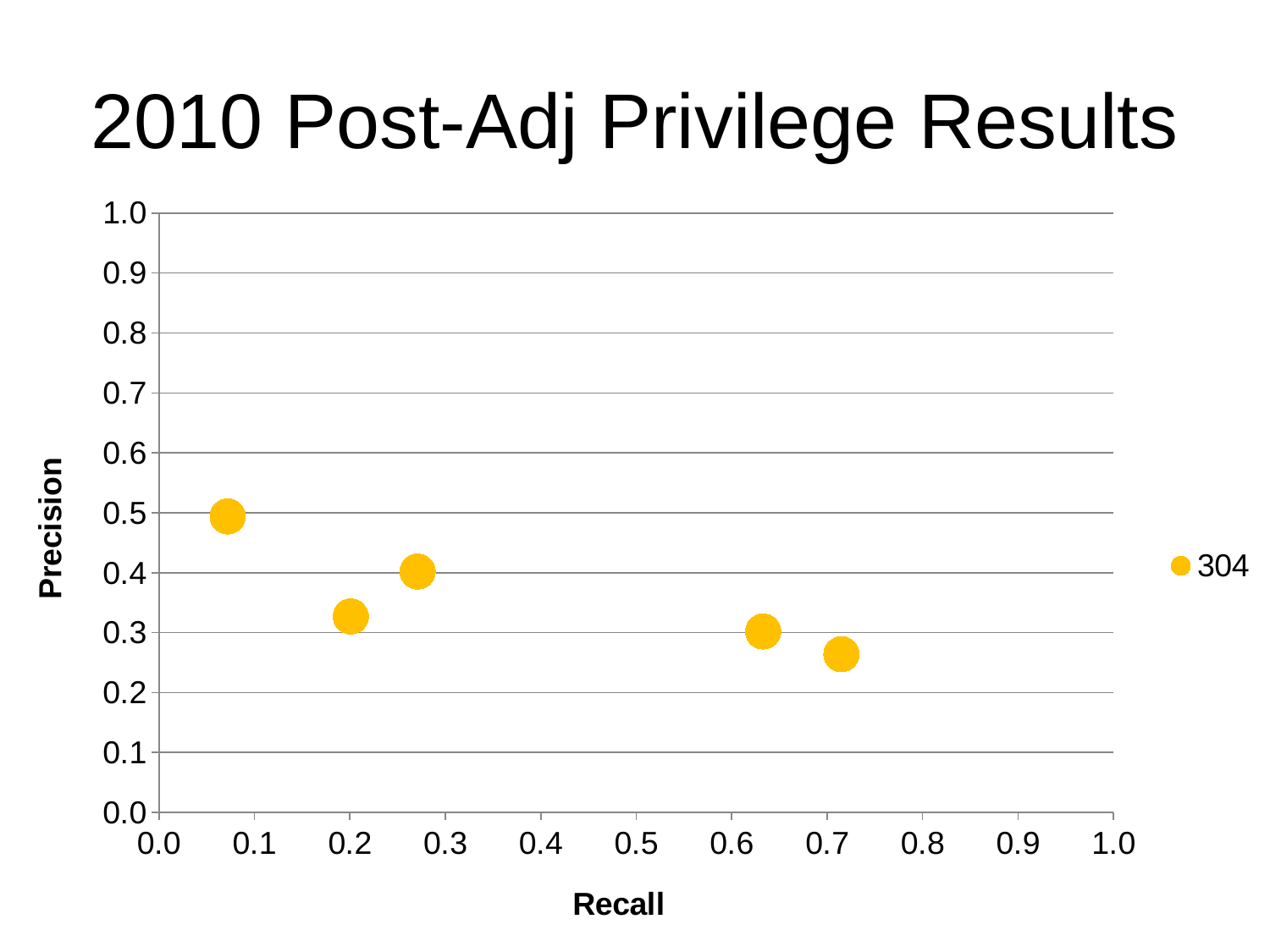
How many data points are plotted on the chart? 5 Is the recall of the point with the highest precision greater or less than 0.2? less How many series does the legend list? 1 What is the title of the chart on the slide? 2010 Post-Adj Privilege Results Is the precision of the point with the highest recall greater or less than 0.4? less Are any points plotted with precision above 0.6? No Which point has the highest precision: the one with the lowest recall or the one with the highest recall? The one with the lowest recall What kind of chart is shown on the slide? Scatter chart Overall, does precision rise or fall as recall increases along the x axis? Fall What is the name of the series shown in the legend? 304